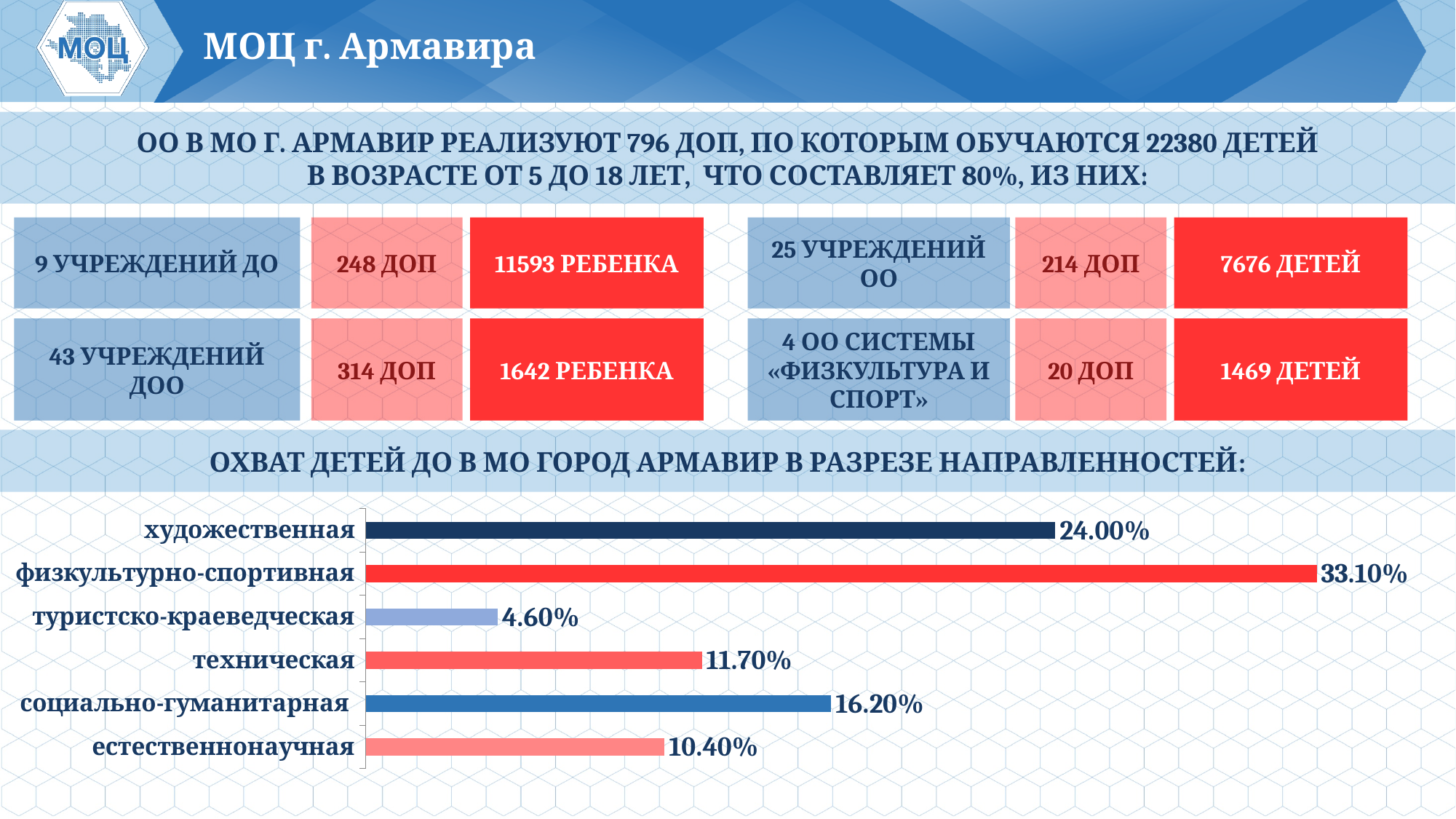
What is the title above the bar chart? ОХВАТ ДЕТЕЙ ДО В МО ГОРОД АРМАВИР В РАЗРЕЗЕ НАПРАВЛЕННОСТЕЙ: What is the difference between the values for физкультурно-спортивная and художественная? 9.10% What kind of chart is shown at the bottom of the slide? bar chart What is the value for туристско-краеведческая in the bar chart? 4.60% Which is larger, the value for техническая or the value for естественнонаучная? техническая Which category has the lowest value in the bar chart? туристско-краеведческая What is the value for художественная in the bar chart? 24.00% How many categories are shown in the bar chart? 6 What is the value for физкультурно-спортивная in the bar chart? 33.10% Which category has the highest value in the bar chart? физкультурно-спортивная What is the value for социально-гуманитарная in the bar chart? 16.20% What is the difference between the values for социально-гуманитарная and техническая? 4.50%